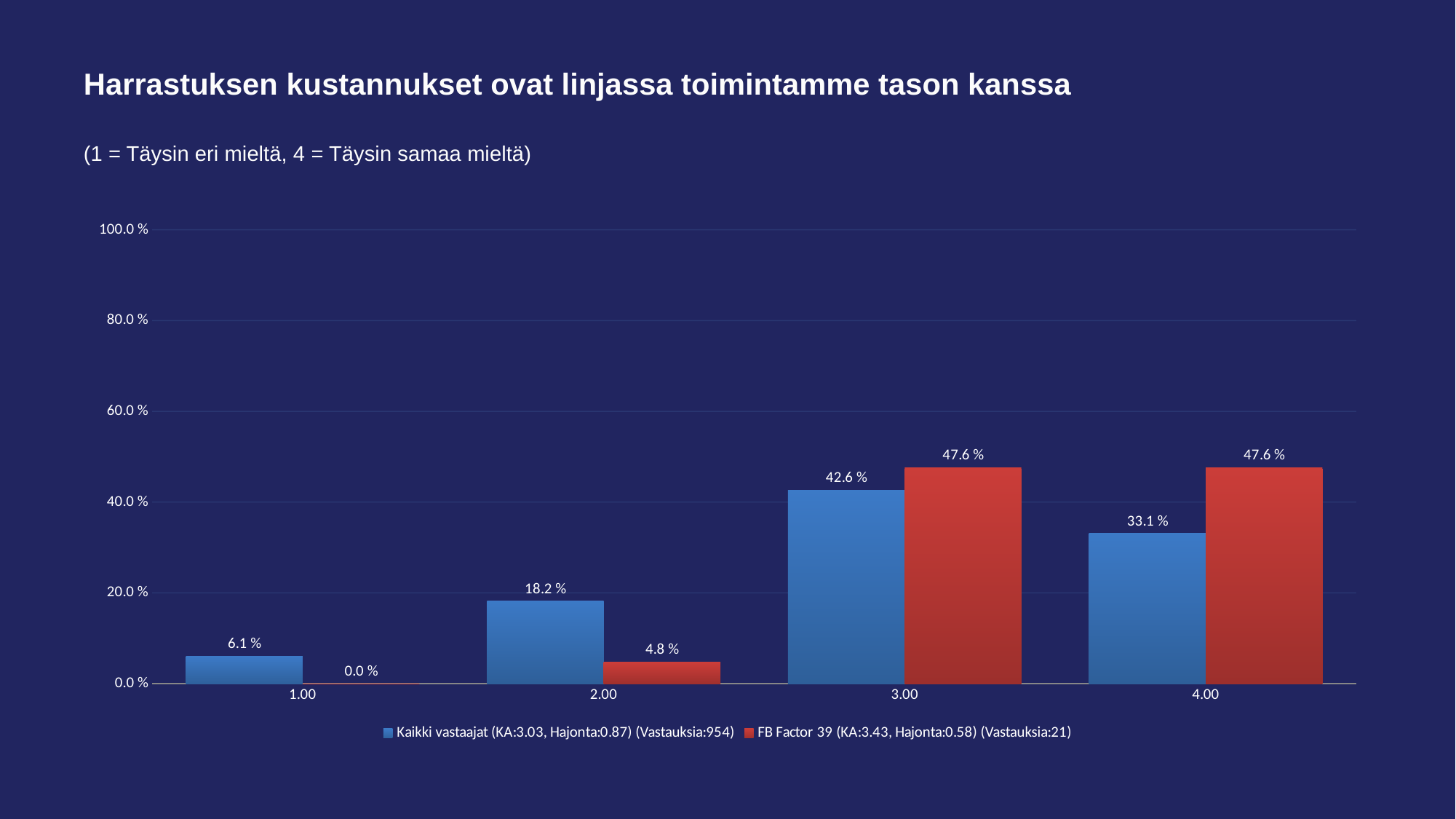
At category 4.00, which series has the larger value, Kaikki vastaajat or FB Factor 39? FB Factor 39 How many series does the legend list? 2 What is the title of the chart? Harrastuksen kustannukset ovat linjassa toimintamme tason kanssa Which category has the highest value for Kaikki vastaajat? 3.00 What is the value for Kaikki vastaajat at category 3.00? 42.6 % What is the difference between the Kaikki vastaajat values at 3.00 and 4.00? 9.5 % How many categories are shown on the x axis? 4 What is the value for FB Factor 39 at category 1.00? 0.0 % Which category has the lowest value for FB Factor 39? 1.00 What is the value for FB Factor 39 at category 2.00? 4.8 % What is the value for Kaikki vastaajat at category 1.00? 6.1 % What kind of chart is shown on the slide? Bar chart